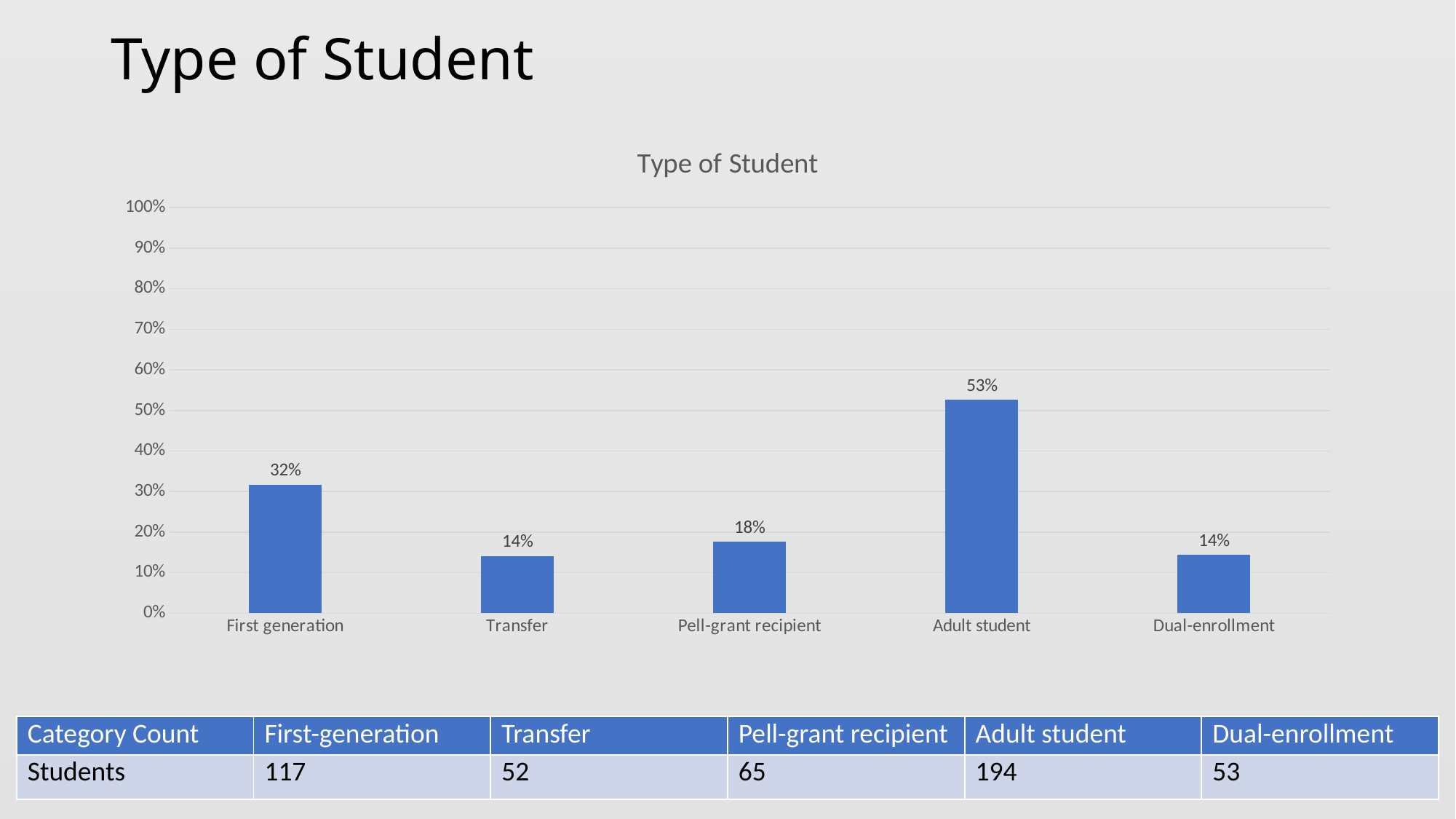
What is the difference between the values for First generation and Pell-grant recipient? 14 percentage points Is the value for Adult student greater or less than 50%? greater Which is larger, the value for First generation or the value for Pell-grant recipient? First generation What is the value for First generation in the chart? 32% Which category has the highest value in the chart? Adult student What is the value for Pell-grant recipient in the chart? 18% What kind of chart is shown on the slide? bar chart How many categories are shown in the chart? 5 What is the title of the chart? Type of Student What is the difference between the values for Adult student and First generation? 21 percentage points What is the value for Adult student in the chart? 53% What is the value for Transfer in the chart? 14%